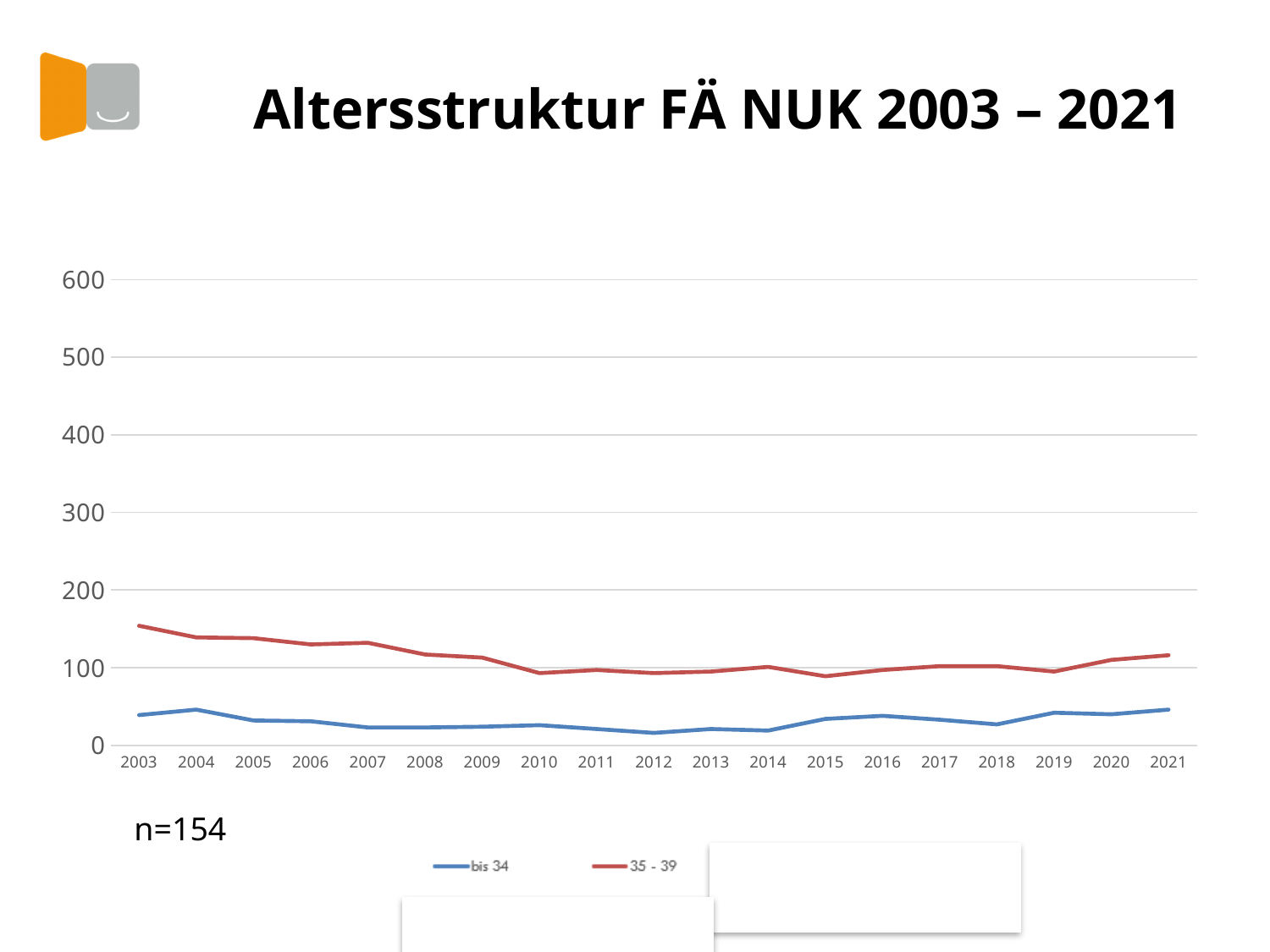
Is the value for 'bis 34' in 2004 greater or less than 100? less How many series does the legend list? 2 Does the '35 - 39' series rise or fall between 2003 and 2010? fall How many years are shown along the x axis? 19 Is the value for '35 - 39' in 2003 greater or less than 100? greater Is the value for '35 - 39' in 2003 greater or less than 200? less What is the title of the chart? Altersstruktur FÄ NUK 2003 – 2021 Which series is higher in 2003, 'bis 34' or '35 - 39'? 35 - 39 What kind of chart is shown on the slide? line chart In which year does the '35 - 39' series reach its highest value? 2003 Which colour is used for the 'bis 34' series? blue